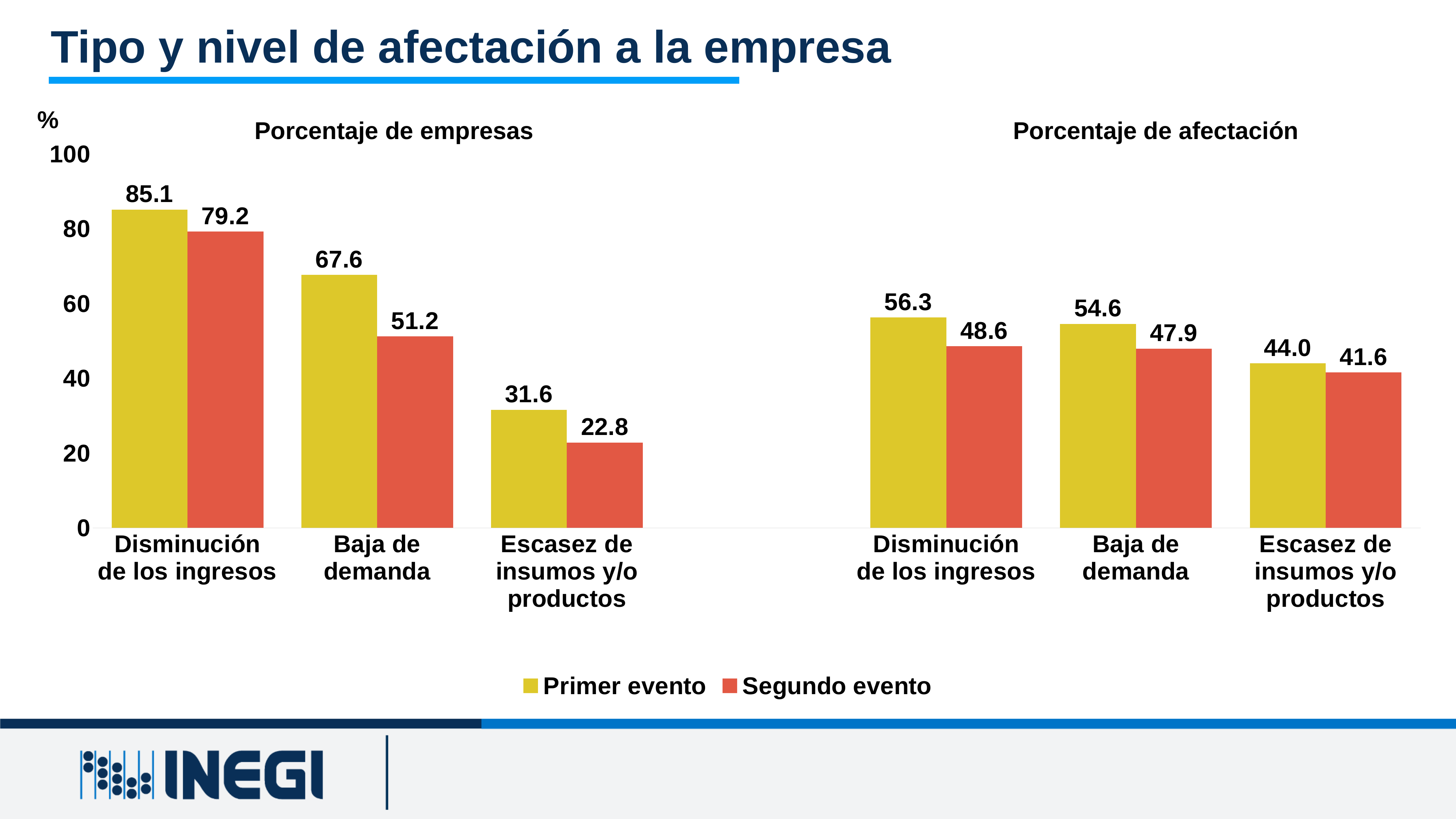
In the 'Porcentaje de afectación' chart, what is the value for Segundo evento for Baja de demanda? 47.9 How many categories are shown in the 'Porcentaje de afectación' chart? 3 In the 'Porcentaje de afectación' chart, what is the difference between Primer evento and Segundo evento for Disminución de los ingresos? 7.7 In the 'Porcentaje de afectación' chart, which category has the lowest Segundo evento value? Escasez de insumos y/o productos In the 'Porcentaje de empresas' chart, what is the value for Primer evento for Disminución de los ingresos? 85.1 In the 'Porcentaje de empresas' chart, which is larger for Escasez de insumos y/o productos: Primer evento or Segundo evento? Primer evento How many series does the legend list? 2 In the 'Porcentaje de empresas' chart, which category has the highest Primer evento value? Disminución de los ingresos In the 'Porcentaje de afectación' chart, what is the value for Primer evento for Escasez de insumos y/o productos? 44.0 What kind of chart is the 'Porcentaje de empresas' chart? Bar chart In the 'Porcentaje de empresas' chart, what is the difference between Primer evento and Segundo evento for Baja de demanda? 16.4 In the 'Porcentaje de empresas' chart, what is the value for Segundo evento for Escasez de insumos y/o productos? 22.8